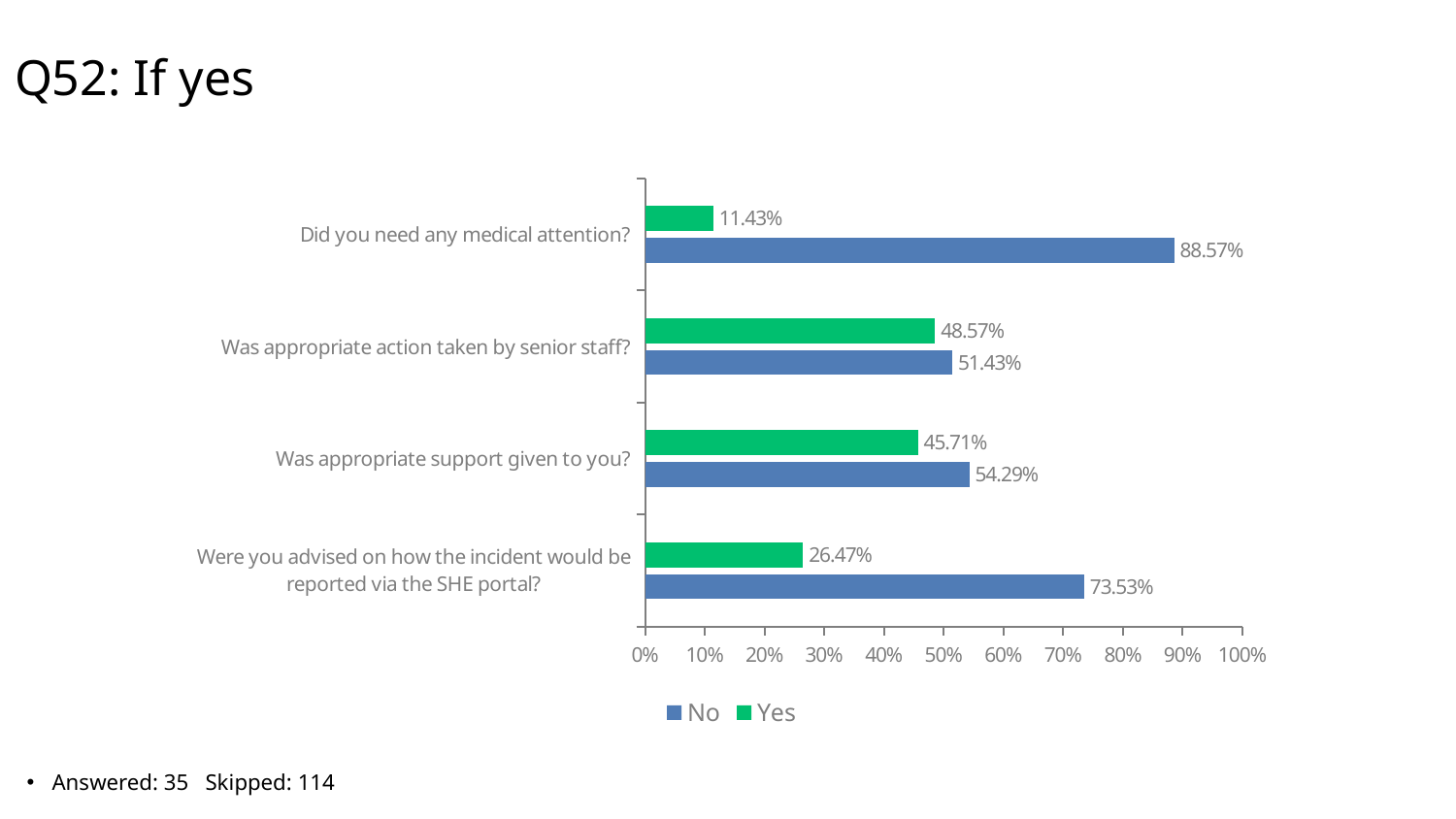
How many series does the legend list? 2 Which question has the highest "Yes" percentage? Was appropriate action taken by senior staff? What is the difference between the "No" and "Yes" values for "Did you need any medical attention?"? 77.14% Which question has the lowest "No" percentage? Was appropriate action taken by senior staff? What type of chart is shown on the slide? bar chart How many questions (categories) are shown on the chart? 4 Is the "Yes" value for "Were you advised on how the incident would be reported via the SHE portal?" greater or less than 30%? less What is the "No" value for "Was appropriate support given to you?"? 54.29% What percentage answered "No" to "Were you advised on how the incident would be reported via the SHE portal?"? 73.53% Which colour represents the "Yes" series? green For "Was appropriate support given to you?", which is larger, the "Yes" or the "No" value? No What percentage answered "Yes" to "Did you need any medical attention?"? 11.43%